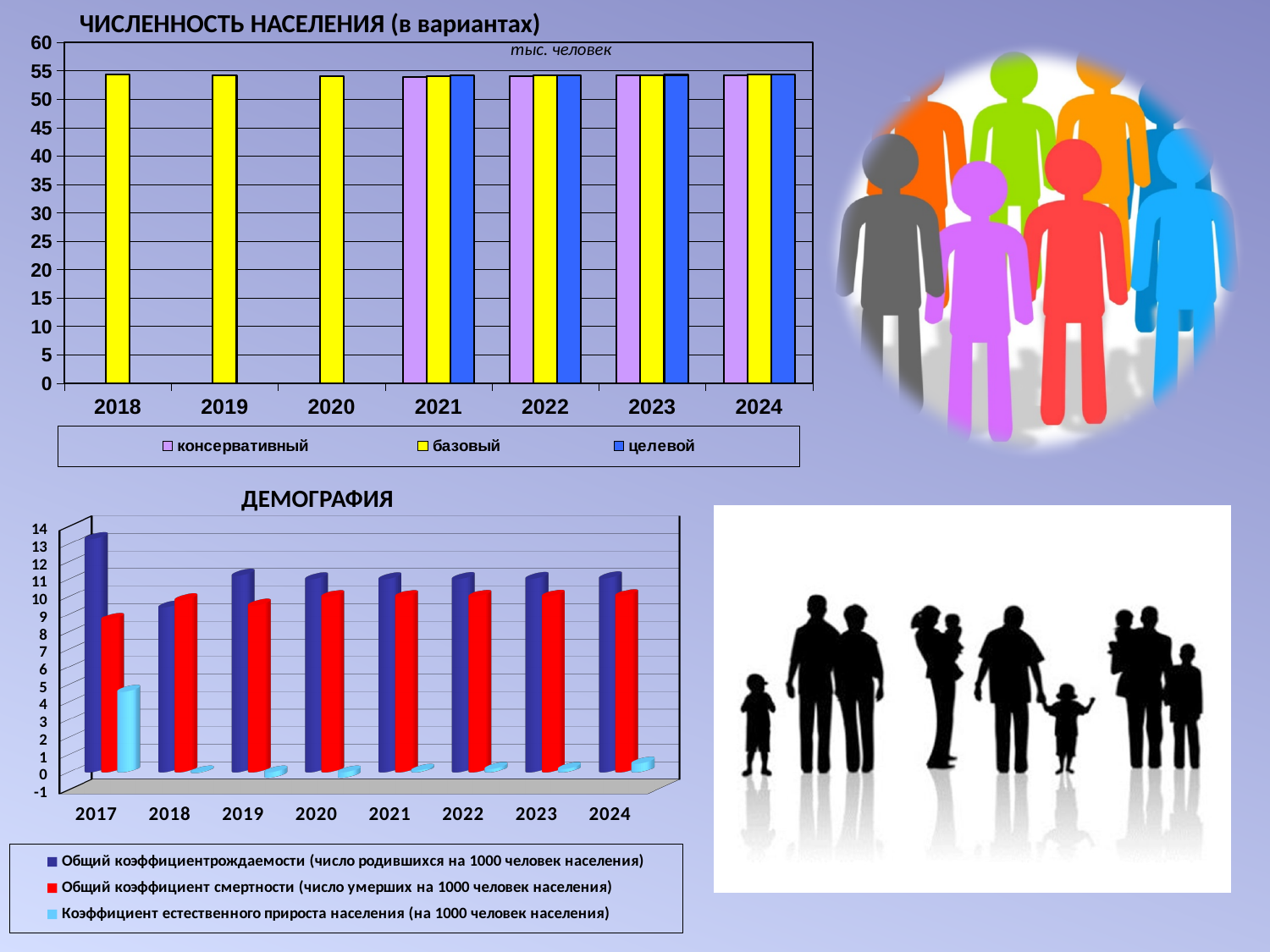
What kind of chart is the top chart titled "ЧИСЛЕННОСТЬ НАСЕЛЕНИЯ (в вариантах)"? bar chart In the top chart "ЧИСЛЕННОСТЬ НАСЕЛЕНИЯ (в вариантах)", what unit is stated above the plot area? тыс. человек In the bottom chart "ДЕМОГРАФИЯ", in which year is the birth rate (Общий коэффициент рождаемости) highest? 2017 How many series does the legend of the bottom chart "ДЕМОГРАФИЯ" list? 3 In the bottom chart "ДЕМОГРАФИЯ", is the birth rate in 2017 greater or less than 12? greater In the top chart "ЧИСЛЕННОСТЬ НАСЕЛЕНИЯ (в вариантах)", is the value for базовый in 2018 greater or less than 50? greater How many years are shown on the x axis of the bottom chart "ДЕМОГРАФИЯ"? 8 In the bottom chart "ДЕМОГРАФИЯ", in which year is the natural population growth coefficient (Коэффициент естественного прироста населения) highest? 2017 How many years are shown on the x axis of the top chart "ЧИСЛЕННОСТЬ НАСЕЛЕНИЯ (в вариантах)"? 7 In the top chart "ЧИСЛЕННОСТЬ НАСЕЛЕНИЯ (в вариантах)", which series is shown in yellow? базовый How many series does the legend of the top chart "ЧИСЛЕННОСТЬ НАСЕЛЕНИЯ (в вариантах)" list? 3 In the bottom chart "ДЕМОГРАФИЯ", which is larger in 2017: the birth rate or the death rate? the birth rate